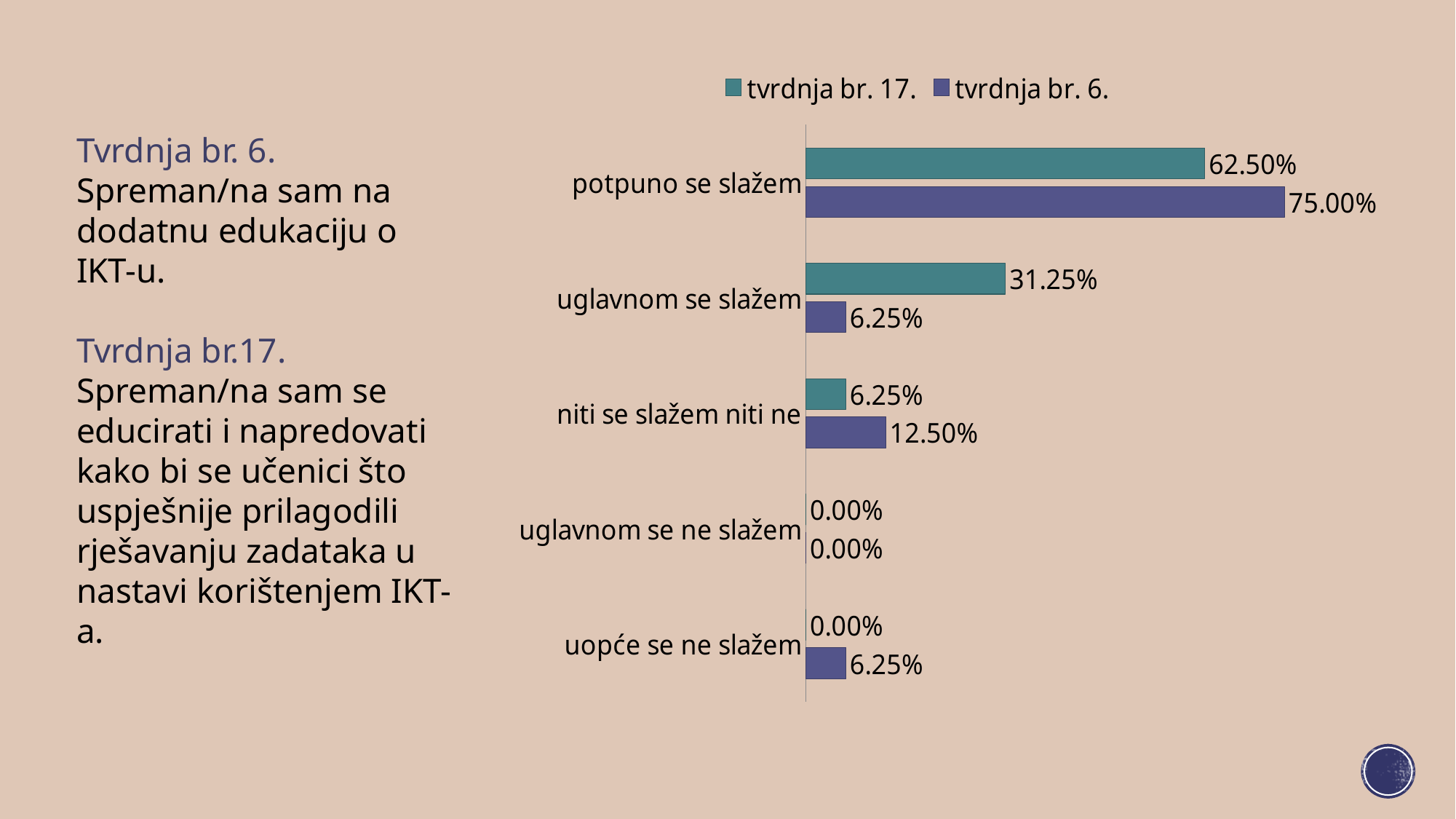
What colour are the bars for "tvrdnja br. 17."? teal How many categories are shown on the chart? 5 What kind of chart is shown on the slide? bar chart What is the difference between the "tvrdnja br. 6." and "tvrdnja br. 17." values in the "potpuno se slažem" category? 12.50% What is the value for "tvrdnja br. 6." in the "uopće se ne slažem" category? 6.25% What is the value for "tvrdnja br. 6." in the "potpuno se slažem" category? 75.00% What is the difference between the "tvrdnja br. 17." and "tvrdnja br. 6." values in the "uglavnom se slažem" category? 25.00% What is the value for "tvrdnja br. 6." in the "niti se slažem niti ne" category? 12.50% In the "niti se slažem niti ne" category, which series has the larger value? tvrdnja br. 6. What is the value for "tvrdnja br. 17." in the "uglavnom se slažem" category? 31.25% Which category has the highest value for "tvrdnja br. 17."? potpuno se slažem How many series does the legend list? 2